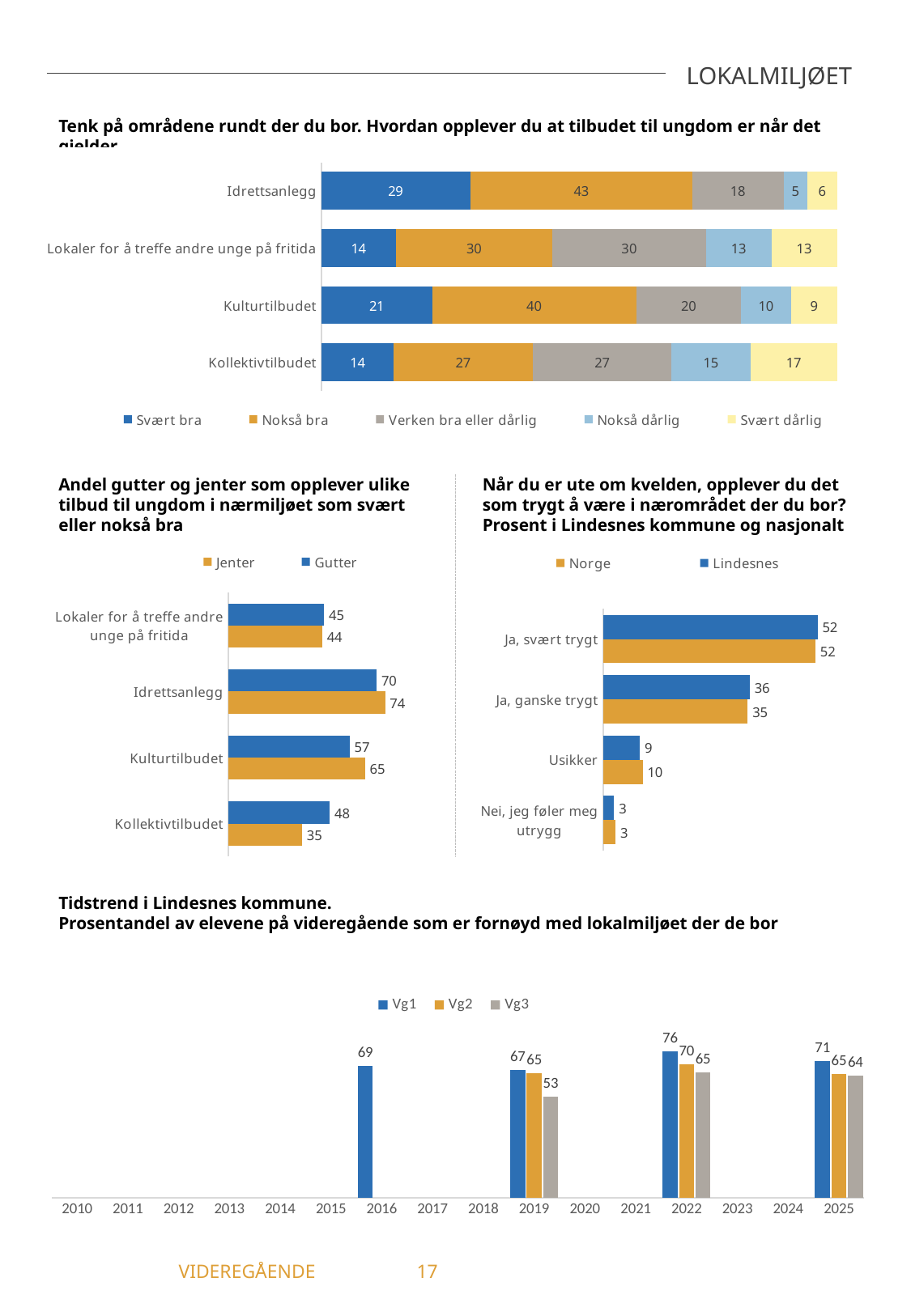
In the top chart 'Tenk på områdene rundt der du bor', how many series does the legend list? 5 In the top chart 'Tenk på områdene rundt der du bor', what is the value for 'Svært bra' for Idrettsanlegg? 29 In the chart 'Tidstrend i Lindesnes kommune', what is the value for Vg3 in 2019? 53 In the top chart 'Tenk på områdene rundt der du bor', what is the value for 'Svært dårlig' for Kollektivtilbudet? 17 In the chart 'Andel gutter og jenter som opplever ulike tilbud til ungdom i nærmiljøet som svært eller nokså bra', what is the difference between Gutter and Jenter for Kollektivtilbudet? 13 In the chart 'Når du er ute om kvelden, opplever du det som trygt å være i nærområdet der du bor?', which category has the lowest value for Norge? Nei, jeg føler meg utrygg In the chart 'Andel gutter og jenter som opplever ulike tilbud til ungdom i nærmiljøet som svært eller nokså bra', which category has the highest value for Gutter? Idrettsanlegg In the chart 'Andel gutter og jenter som opplever ulike tilbud til ungdom i nærmiljøet som svært eller nokså bra', what is the value for Jenter for Kulturtilbudet? 65 In the chart 'Tidstrend i Lindesnes kommune', what is the value for Vg1 in 2022? 76 In the chart 'Når du er ute om kvelden, opplever du det som trygt å være i nærområdet der du bor?', what is the value for Lindesnes for 'Ja, ganske trygt'? 36 In the top chart 'Tenk på områdene rundt der du bor', which category has the highest 'Nokså bra' value? Idrettsanlegg What kind of chart is 'Tidstrend i Lindesnes kommune'? Bar chart